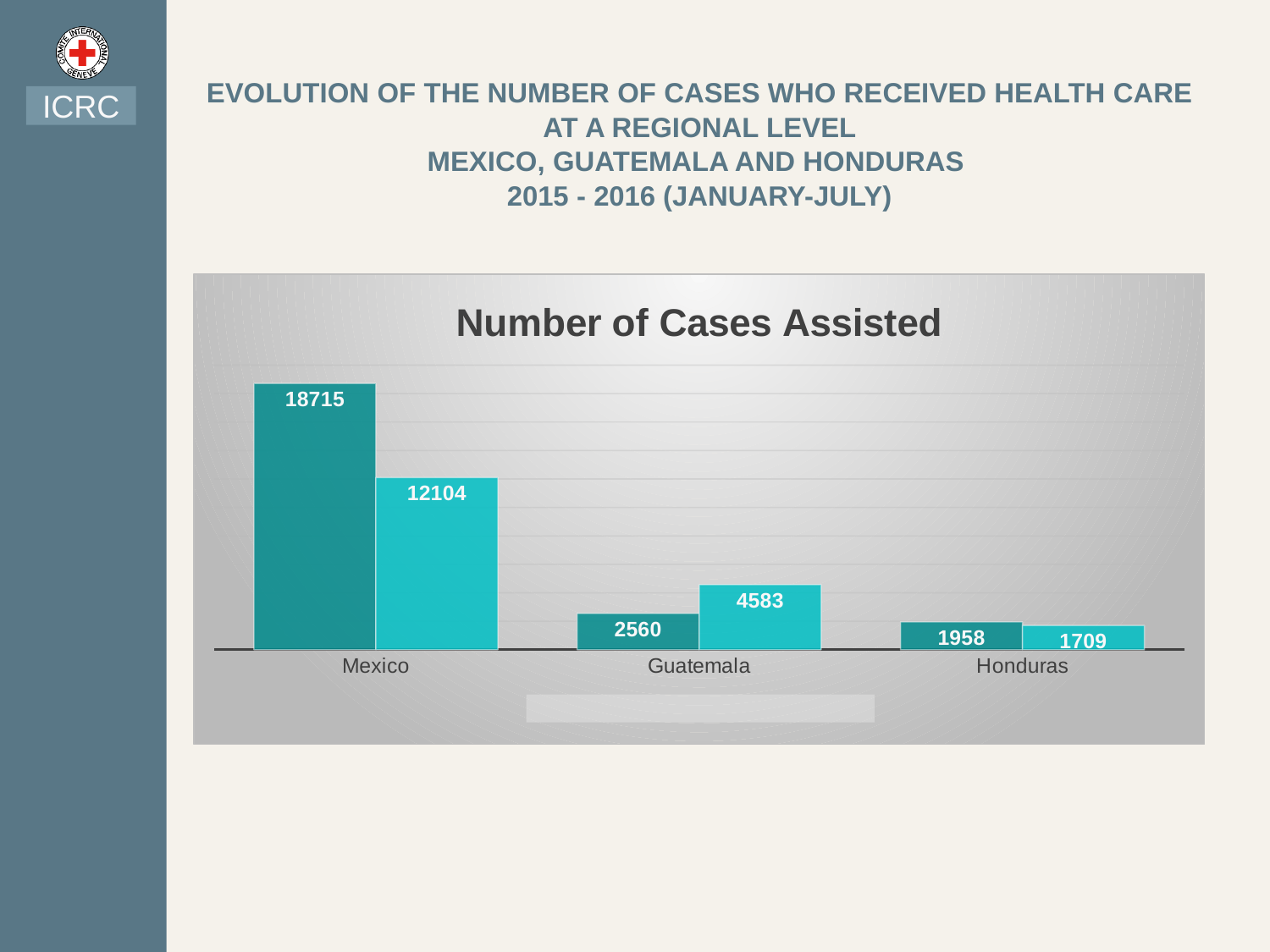
What is the value of the lighter (right) bar for Guatemala? 4583 What is the value of the darker (left) bar for Mexico in the Number of Cases Assisted chart? 18715 What is the value of the lighter (right) bar for Mexico? 12104 Which country has the lowest value in the chart? Honduras For Guatemala, which bar is larger, the darker (left) one or the lighter (right) one? the lighter (right) one What is the value of the darker (left) bar for Honduras? 1958 What is the difference between the two bars for Mexico? 6611 What type of chart is shown on the slide? bar chart What is the value of the darker (left) bar for Guatemala? 2560 What is the value of the lighter (right) bar for Honduras? 1709 Which country has the highest value in the chart? Mexico How many countries are shown on the x axis of the chart? 3